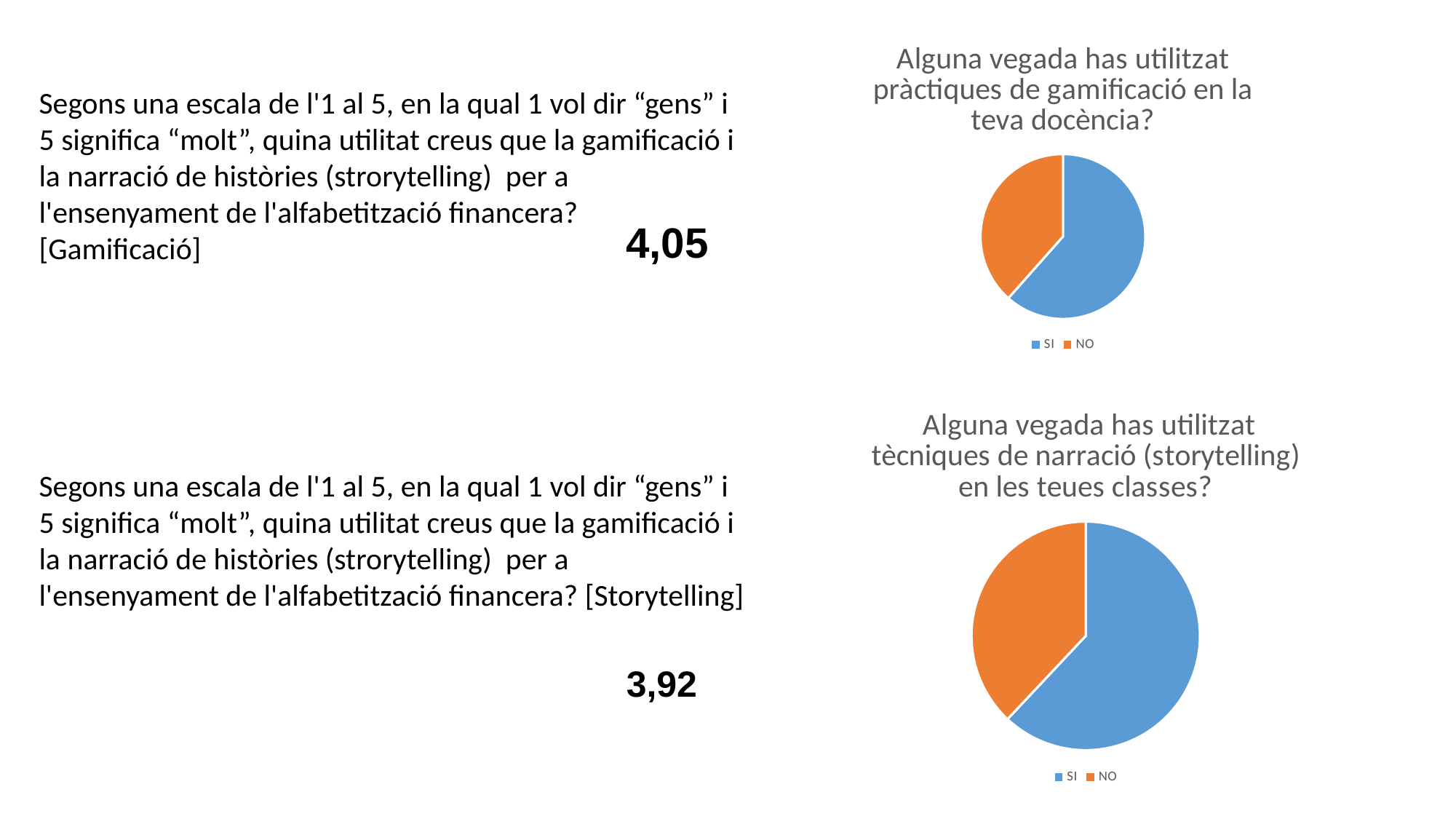
What kind of chart is the top-right chart titled "Alguna vegada has utilitzat pràctiques de gamificació en la teva docència?"? pie chart In the bottom-right pie chart about storytelling, which is larger, SI or NO? SI What colour is the SI slice in the top-right pie chart about gamificació? blue How many slices does the top-right pie chart about gamificació have? 2 What kind of chart is the bottom-right chart titled "Alguna vegada has utilitzat tècniques de narració (storytelling) en les teues classes?"? pie chart In the top-right pie chart about gamificació, which slice is the smallest? NO In the bottom-right pie chart about storytelling, which slice is the smallest? NO How many entries does the legend of the bottom-right pie chart about storytelling list? 2 What is the title of the bottom-right pie chart? Alguna vegada has utilitzat tècniques de narració (storytelling) en les teues classes? In the top-right pie chart about gamificació, which slice is larger, SI or NO? SI